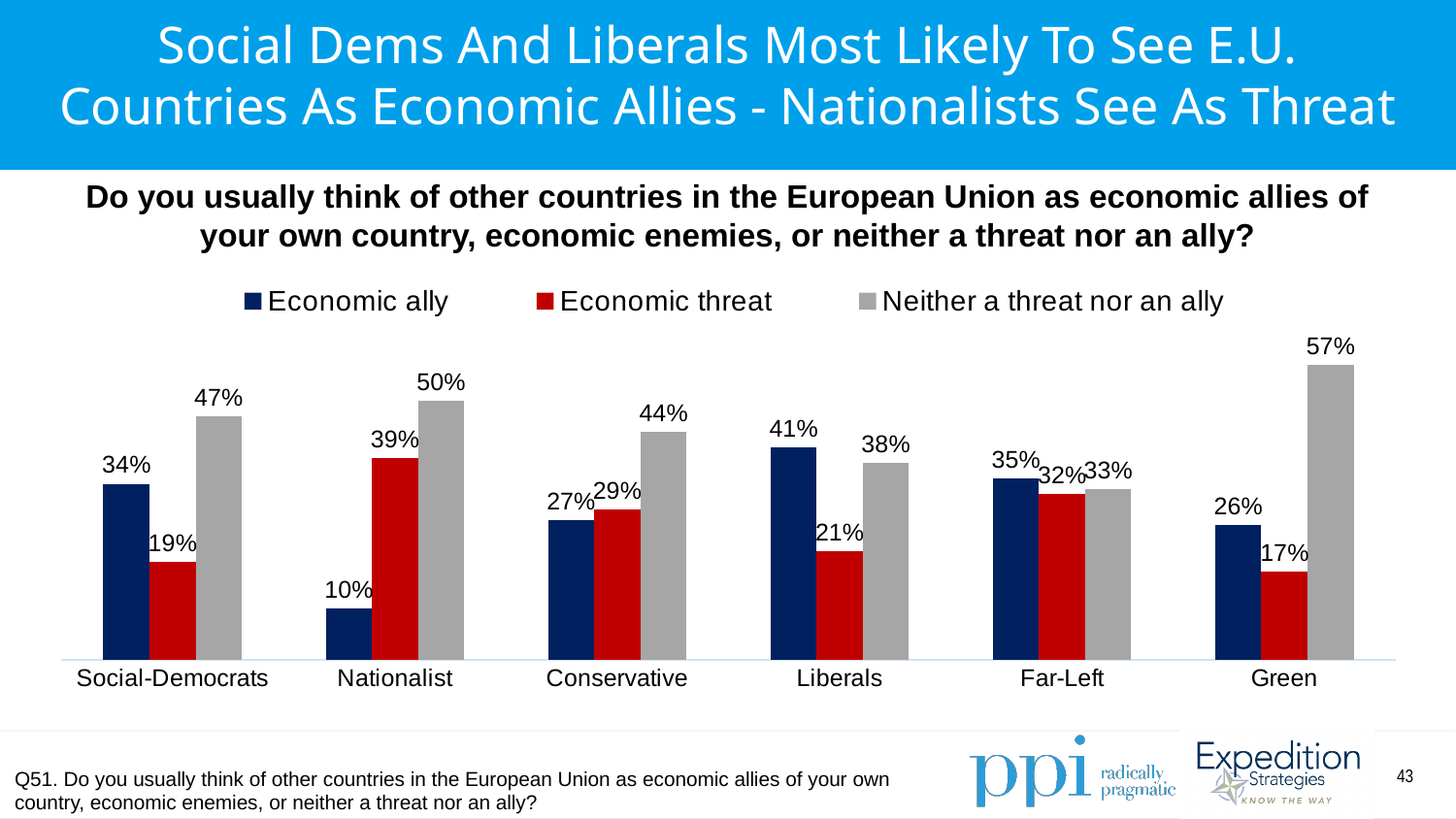
Which party group has the highest share saying other E.U. countries are an economic threat? Nationalist What percentage of Nationalists see other E.U. countries as an economic threat? 39% What type of chart is shown on the slide? Bar chart What is the difference between the Nationalist and Social-Democrats 'Economic ally' percentages? 24 percentage points Which colour represents 'Economic threat' in the chart? Red What percentage of Liberals see other E.U. countries as an economic ally? 41% What percentage of Greens say other E.U. countries are neither a threat nor an ally? 57% How many series does the legend list? 3 Which party group has the highest share saying other E.U. countries are an economic ally? Liberals Which party group has the lowest share saying other E.U. countries are an economic ally? Nationalist How many party groups are shown on the x axis? 6 Is the 'Economic threat' percentage higher for Conservatives or for Liberals? Conservative